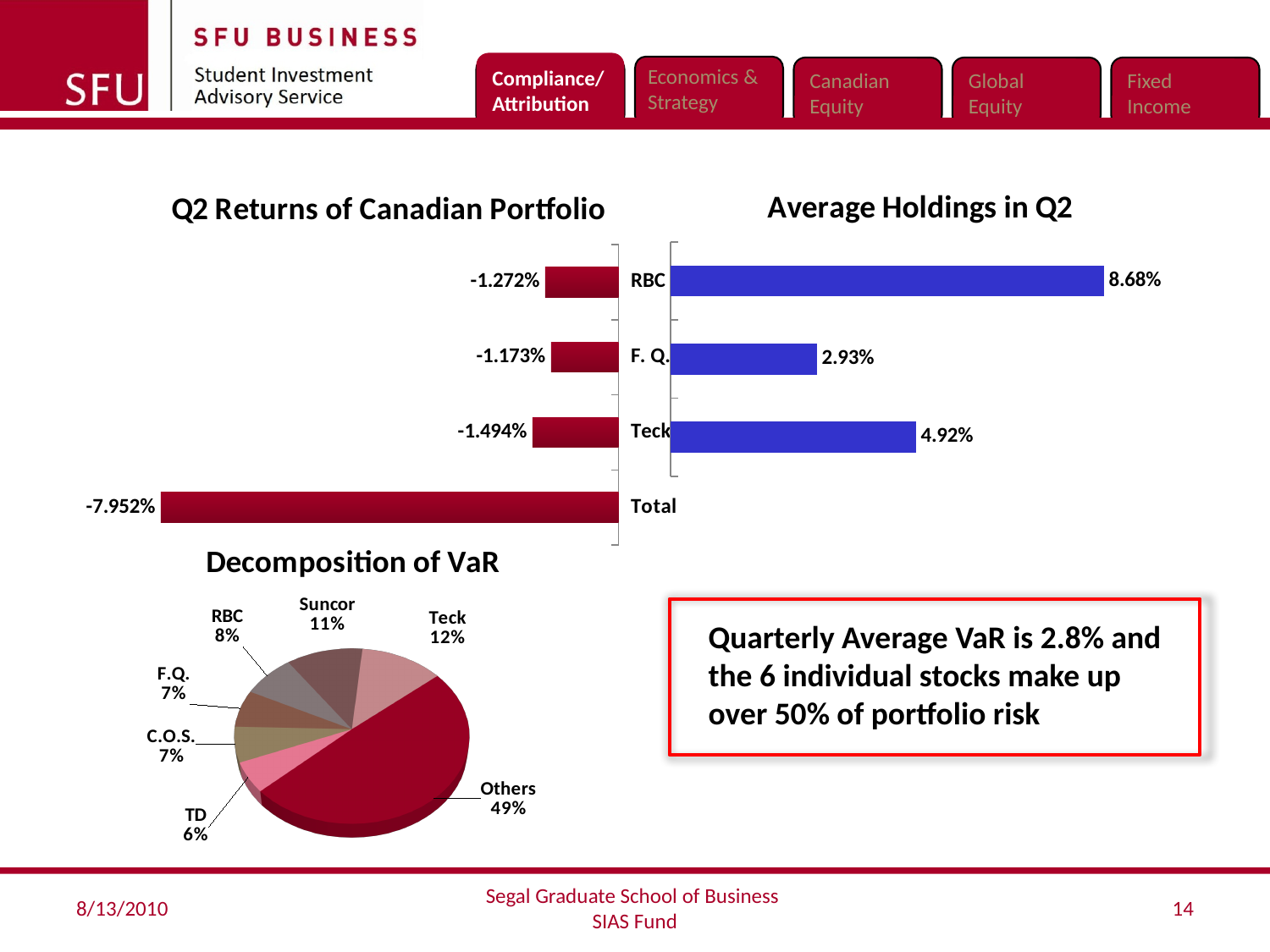
How many slices does the "Decomposition of VaR" pie chart have? 7 In the "Average Holdings in Q2" chart, which holding has the lowest value? F. Q. In the "Decomposition of VaR" pie chart, what share does Others have? 49% In the "Average Holdings in Q2" chart, what is the difference between the RBC and Teck values? 3.76% What kind of chart is "Q2 Returns of Canadian Portfolio"? Bar chart In the "Q2 Returns of Canadian Portfolio" chart, what is the Total return? -7.952% In the "Average Holdings in Q2" chart, what is the value for RBC? 8.68% In the "Decomposition of VaR" pie chart, what is the share for TD? 6% In the "Q2 Returns of Canadian Portfolio" chart, what is the return for Teck? -1.494% In the "Q2 Returns of Canadian Portfolio" chart, which of RBC or F. Q. has the larger (less negative) return? F. Q. What kind of chart is "Decomposition of VaR"? Pie chart In the "Decomposition of VaR" pie chart, which named stock has the largest share? Teck